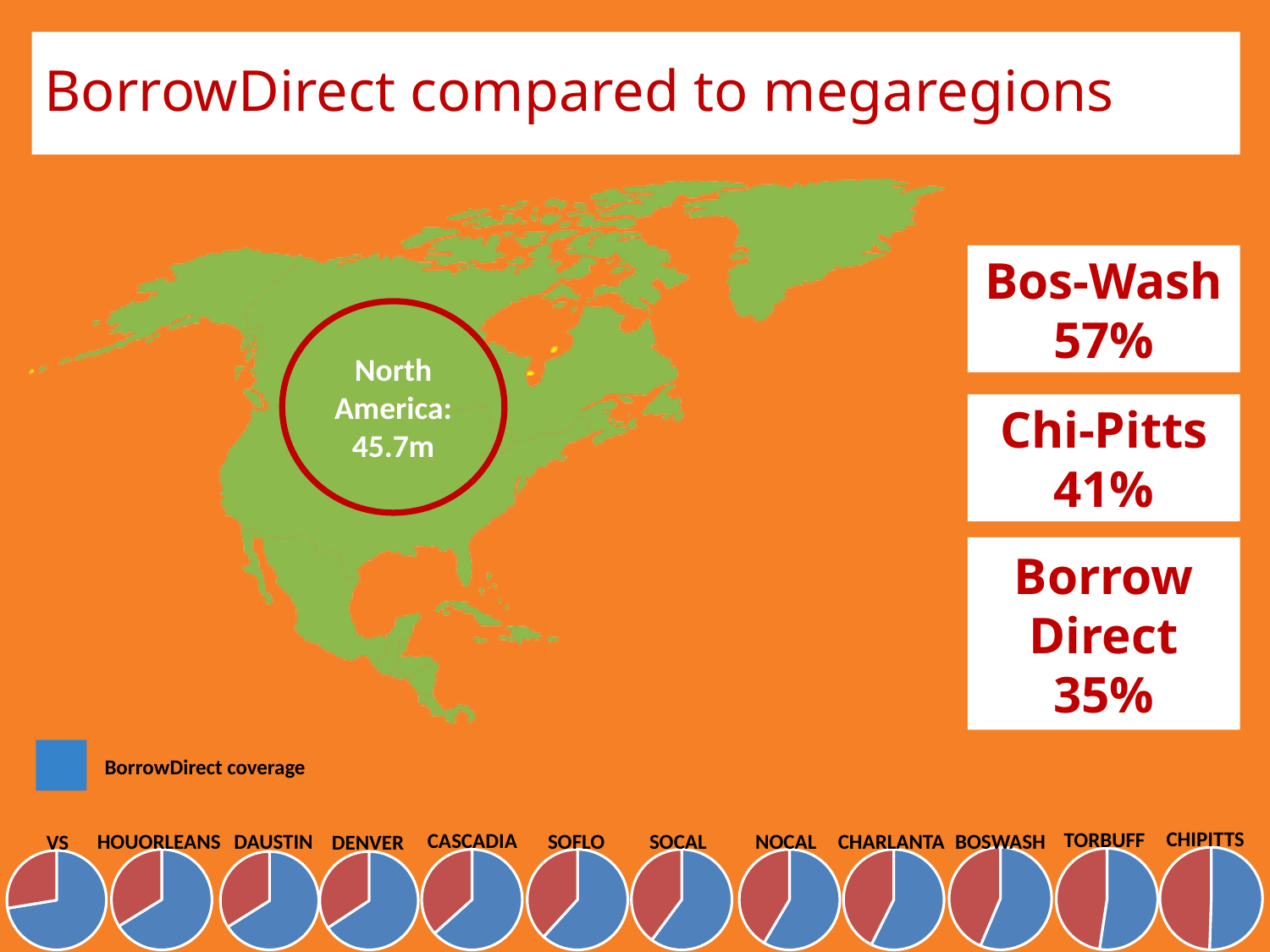
Which of the three regions listed on the right has the lowest percentage? BorrowDirect How many pie charts are shown along the bottom of the slide? 12 Which has a higher percentage, Chi-Pitts or BorrowDirect? Chi-Pitts What percentage is shown for Chi-Pitts in the boxes on the right of the slide? 41% According to the legend, what does the blue colour in the pie charts represent? BorrowDirect coverage What percentage is shown for Bos-Wash in the boxes on the right of the slide? 57% What value is shown inside the circle on the map for North America? 45.7m What is the difference in percentage points between Bos-Wash and BorrowDirect? 22 Which of the three regions listed on the right has the highest percentage? Bos-Wash What percentage is shown for BorrowDirect in the boxes on the right of the slide? 35% What kind of charts are shown along the bottom of the slide? Pie charts What is the label of the pie chart at the far right of the row? CHIPITTS